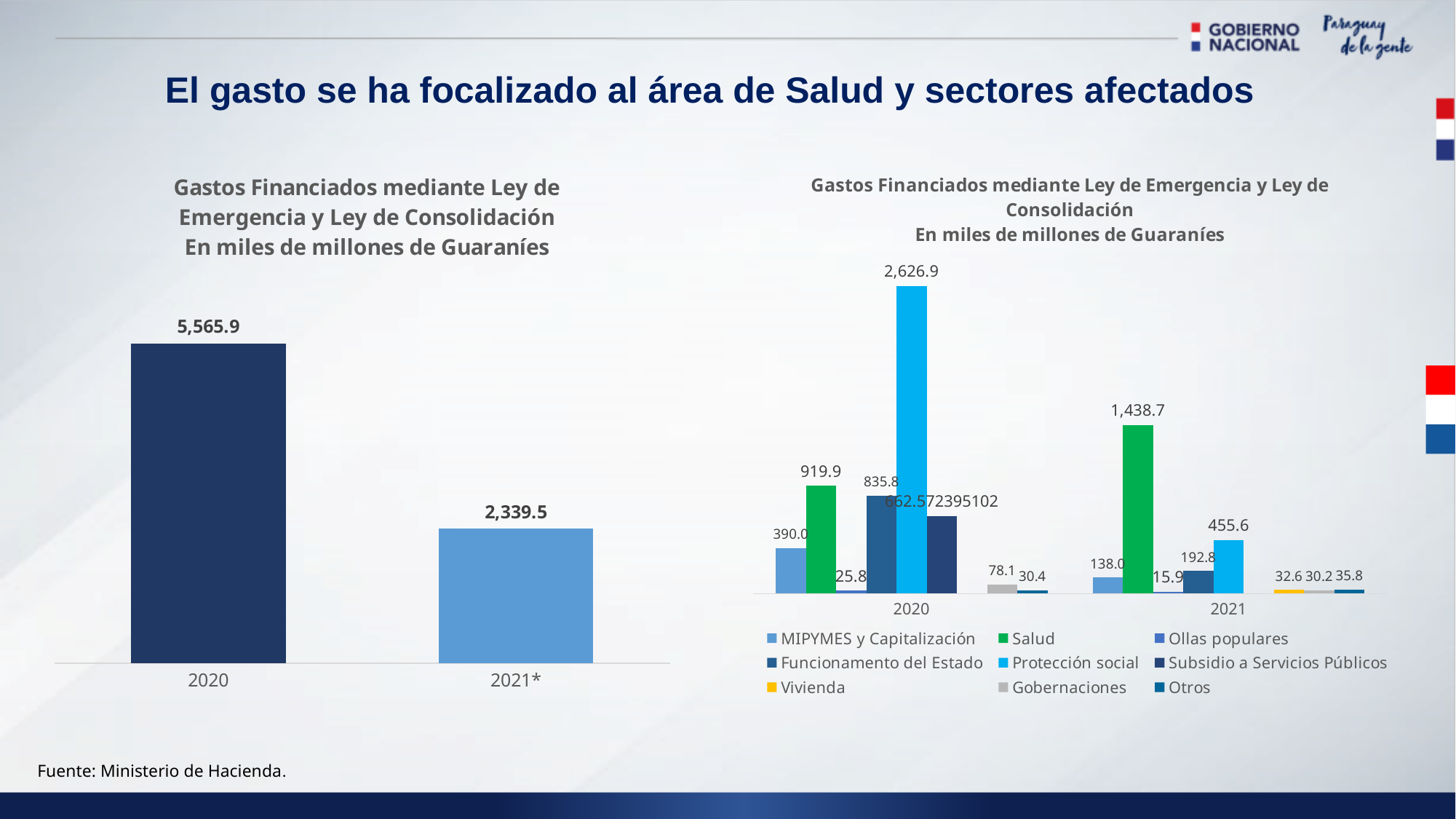
In the left chart, what is the value for 2021*? 2,339.5 In the right chart, what is the difference between Salud in 2021 and Salud in 2020? 518.8 In the left chart, what is the value for 2020? 5,565.9 In the right chart, how many series does the legend list? 9 In the right chart, what is the value for Salud in 2021? 1,438.7 In the right chart, which is larger: MIPYMES y Capitalización in 2020 or in 2021? 2020 In the left chart, what is the difference between the 2020 and 2021* values? 3,226.4 What kind of chart is the left chart? bar chart In the right chart, what is the value for Gobernaciones in 2020? 78.1 In the right chart, what is the value for Protección social in 2020? 2,626.9 In the right chart, which series has the highest value in 2021? Salud In the right chart, which series has the highest value in 2020? Protección social